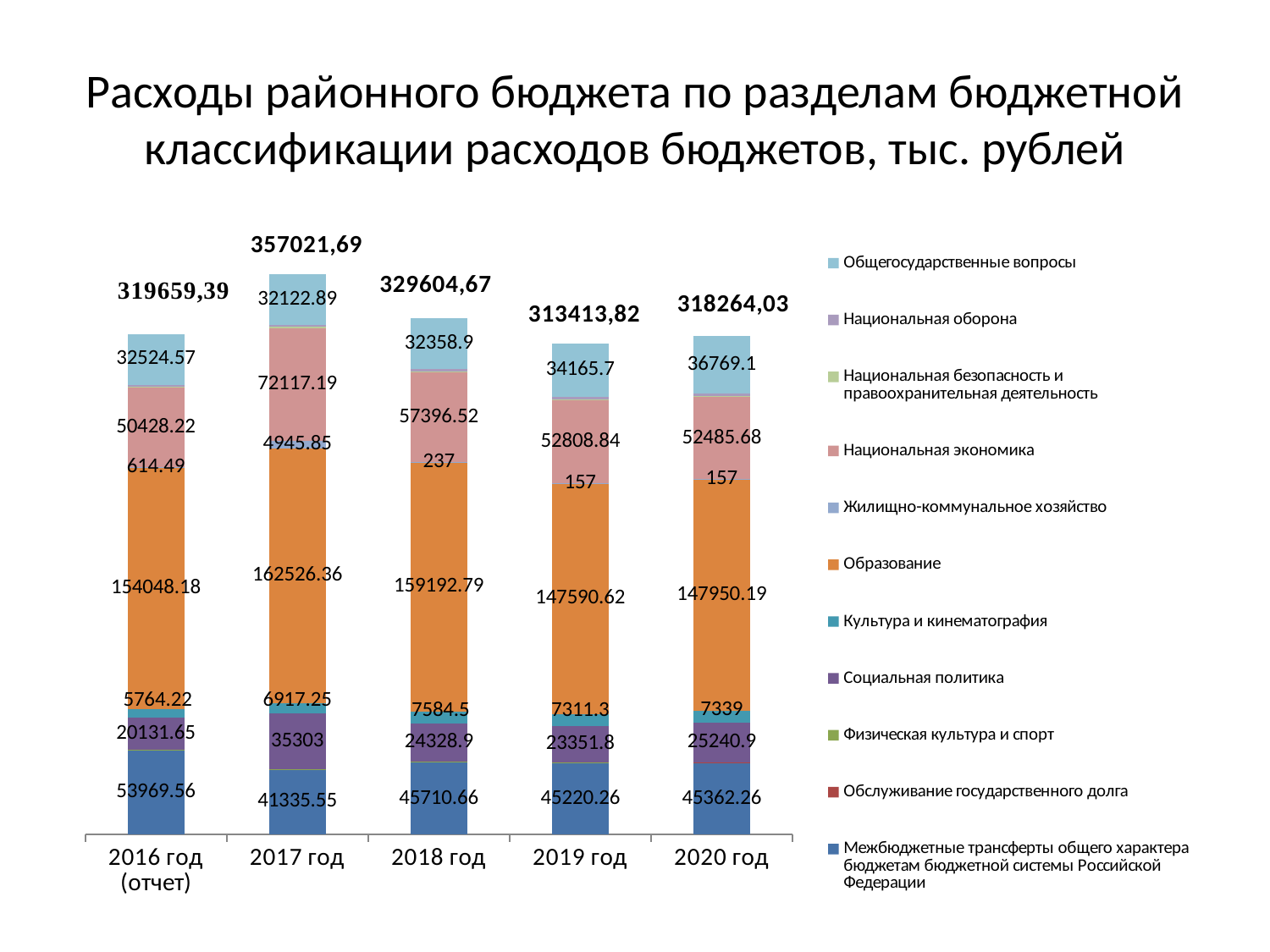
What is the value for Межбюджетные трансферты общего характера бюджетам бюджетной системы Российской Федерации in 2016 год (отчет)? 53969.56 What is the difference between the Образование values for 2018 год and 2019 год? 11602.17 Which is larger: Социальная политика in 2017 год or in 2020 год? 2017 год What is the value for Общегосударственные вопросы in 2020 год? 36769.1 What kind of chart is shown on the slide? Stacked bar chart What is the total of the stacked bar for 2016 год (отчет)? 319659,39 What is the value for Национальная экономика in 2018 год? 57396.52 How many series does the legend list? 11 How many years are shown on the x axis? 5 Which year has the lowest total expenditure? 2019 год Which year has the highest total expenditure? 2017 год What is the value for Образование in 2017 год? 162526.36